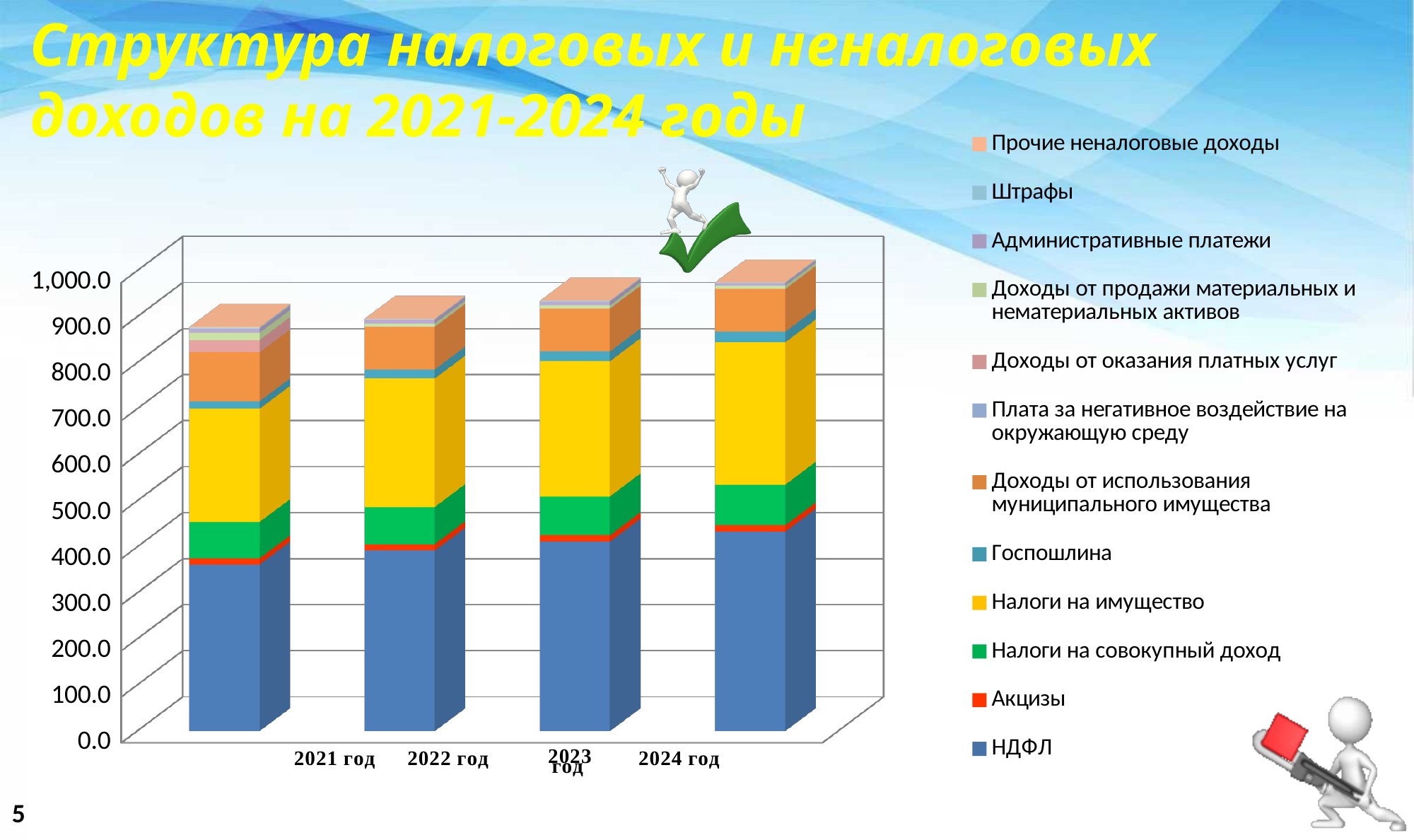
What kind of chart is shown on the slide? Stacked bar chart Which year has the tallest stacked bar? 2024 год Is the НДФЛ segment for 2024 год greater or less than 400.0? greater How many years (categories) are shown on the x axis of the chart? 4 Which year has the shortest stacked bar? 2021 год How many series does the chart legend list? 12 Is the total height of the 2024 год bar greater or less than 900.0? greater Do the total heights of the stacked bars rise or fall from 2021 to 2024? Rise Is the total height of the 2021 год bar greater or less than 1,000.0? less Which series is shown in yellow in the chart legend? Налоги на имущество Which stacked bar is taller, 2021 год or 2024 год? 2024 год